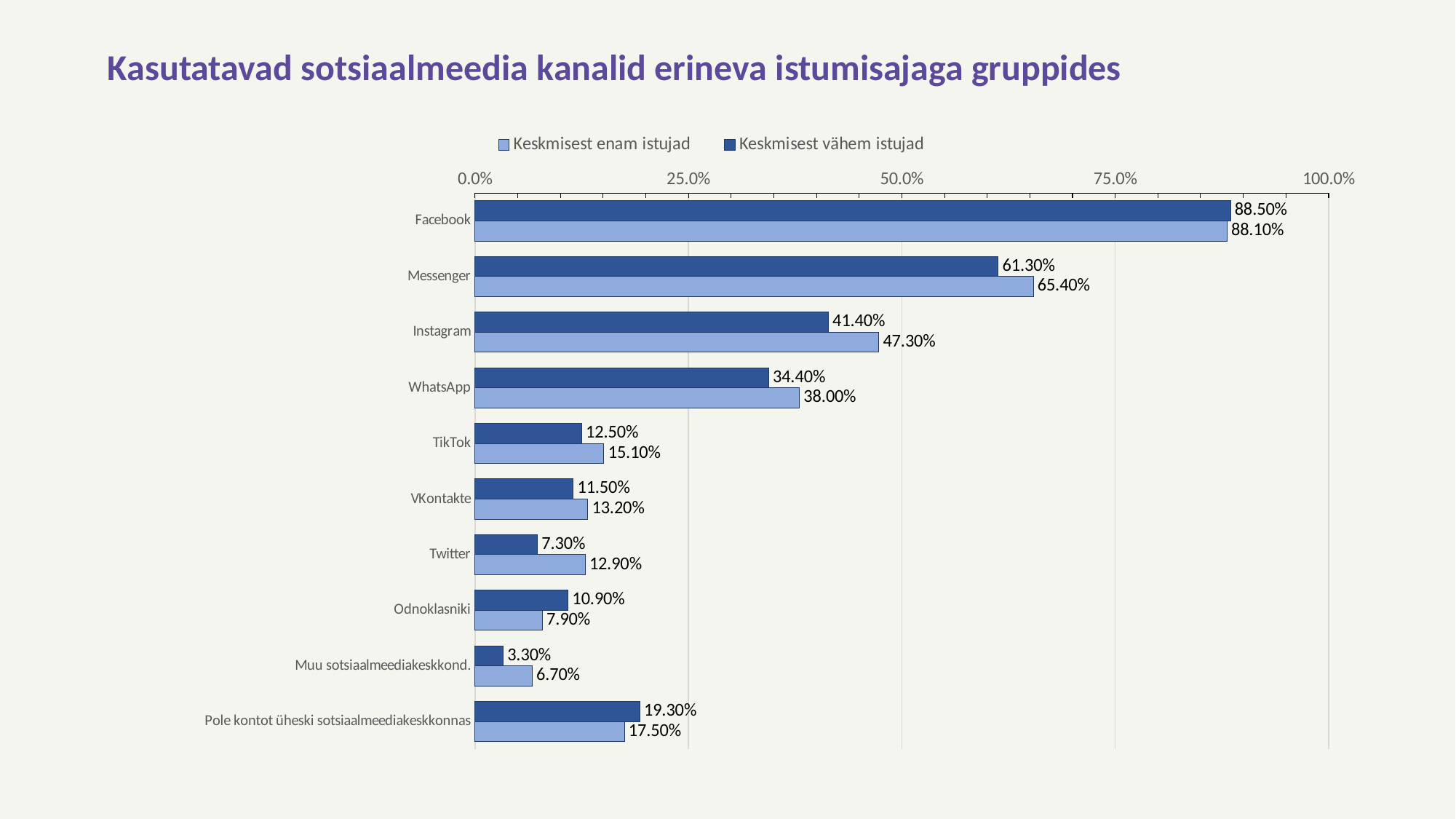
Which category has the lowest value in the 'Keskmisest enam istujad' series? Muu sotsiaalmeediakeskkond. What is the difference between the 'Keskmisest enam istujad' and 'Keskmisest vähem istujad' values for WhatsApp? 3.60% How many series does the legend list? 2 What is the value for Twitter in the 'Keskmisest enam istujad' series? 12.90% What is the value for Instagram in the 'Keskmisest vähem istujad' series? 41.40% For Odnoklasniki, which series has the larger value: 'Keskmisest enam istujad' or 'Keskmisest vähem istujad'? Keskmisest vähem istujad Which category has the highest value in the 'Keskmisest vähem istujad' series? Facebook What type of chart is shown on the slide? bar chart How many categories are shown on the chart? 10 What is the title of the chart? Kasutatavad sotsiaalmeedia kanalid erineva istumisajaga gruppides What is the value for Messenger in the 'Keskmisest enam istujad' series? 65.40% Is the value for Messenger in the 'Keskmisest vähem istujad' series greater or less than 50.0%? greater